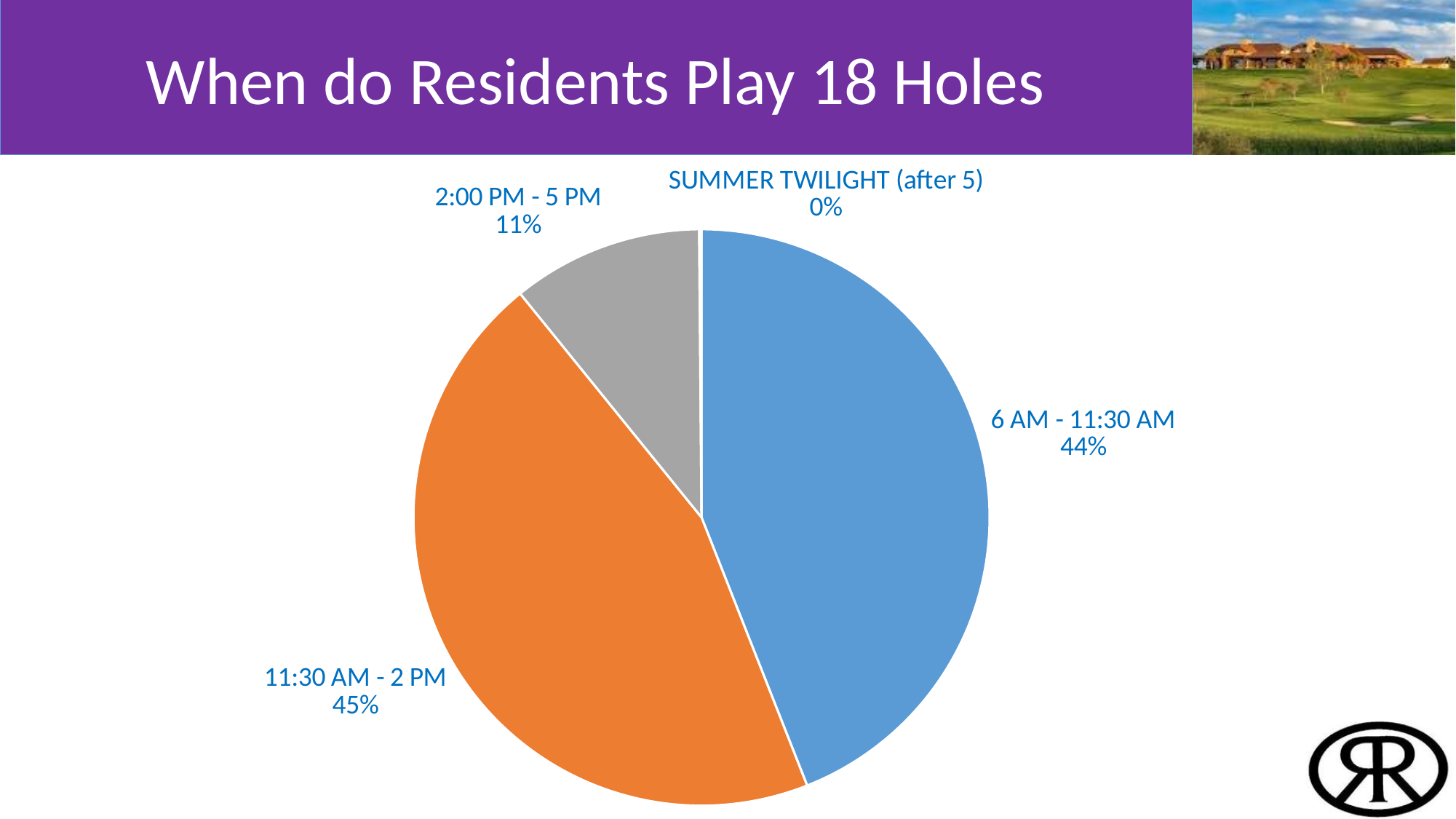
Which time slot has the smallest share of the pie? SUMMER TWILIGHT (after 5) Which is larger: the 6 AM - 11:30 AM slice or the 2:00 PM - 5 PM slice? 6 AM - 11:30 AM What type of chart is shown on the slide? Pie chart What colour is the 11:30 AM - 2 PM slice? Orange What percentage is shown for the 11:30 AM - 2 PM slice? 45% What is the difference in percentage points between the 11:30 AM - 2 PM slice and the 2:00 PM - 5 PM slice? 34 What is the title of the slide containing the chart? When do Residents Play 18 Holes What percentage is shown for the 2:00 PM - 5 PM slice? 11% How many time-slot categories are labelled on the pie chart? 4 What share of residents play 18 holes between 6 AM and 11:30 AM? 44% What percentage is shown for SUMMER TWILIGHT (after 5)? 0% Which time slot has the largest share of the pie? 11:30 AM - 2 PM